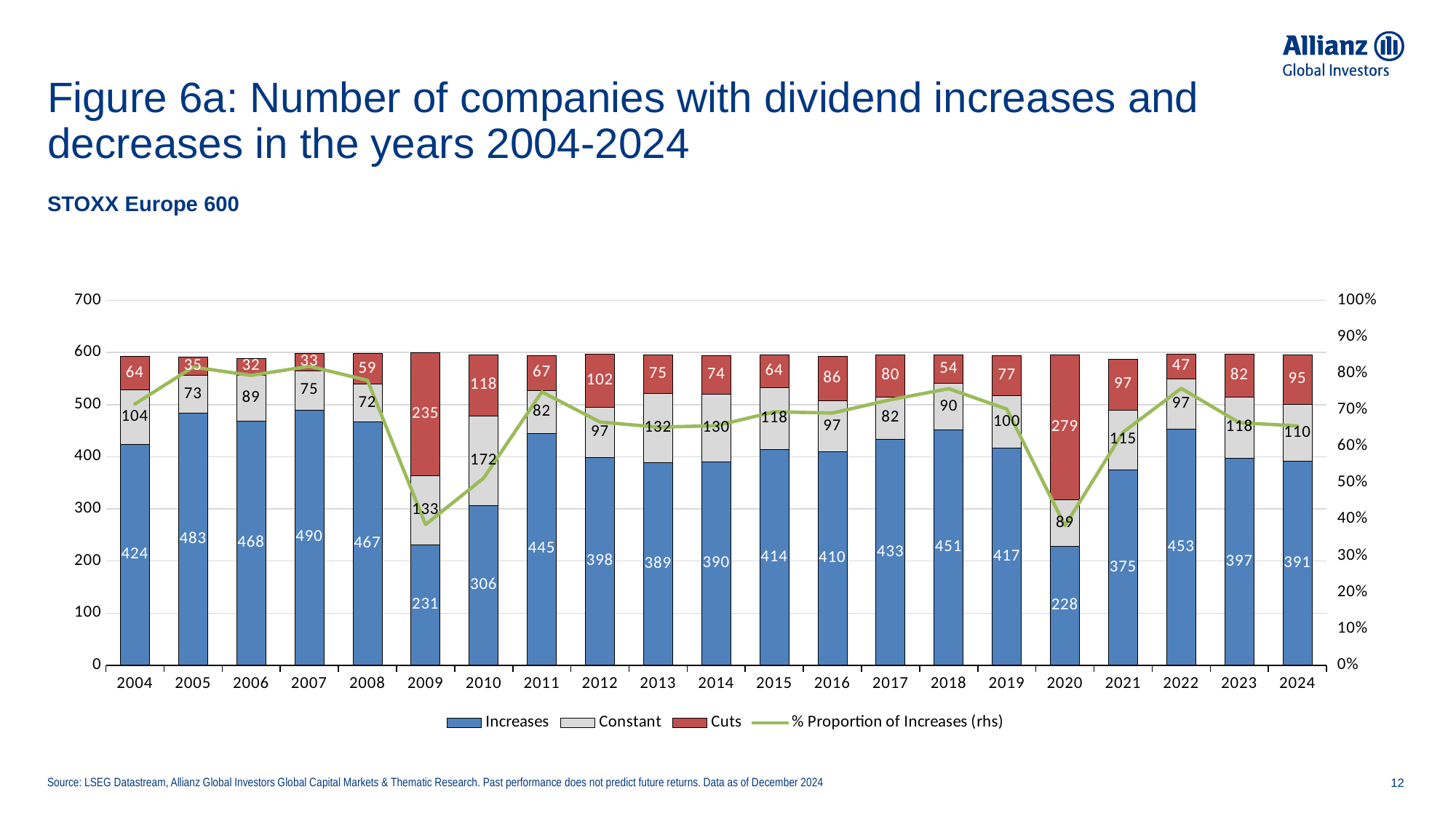
What is the total height of the stacked bar for 2004 (Increases + Constant + Cuts)? 592 Is the % Proportion of Increases for 2009 greater or less than 50%? less How many years are shown on the x axis? 21 What is the difference between the number of cuts in 2020 and in 2009? 44 Which year had more companies with dividend increases, 2005 or 2022? 2005 How many companies kept dividends constant in 2010? 172 What is the value of the Cuts series for 2020? 279 What colour represents the Cuts series? Red In which year was the number of dividend cuts highest? 2020 How many companies had dividend increases in 2007? 490 In which year was the number of companies with dividend increases lowest? 2020 How many series does the legend list? 4